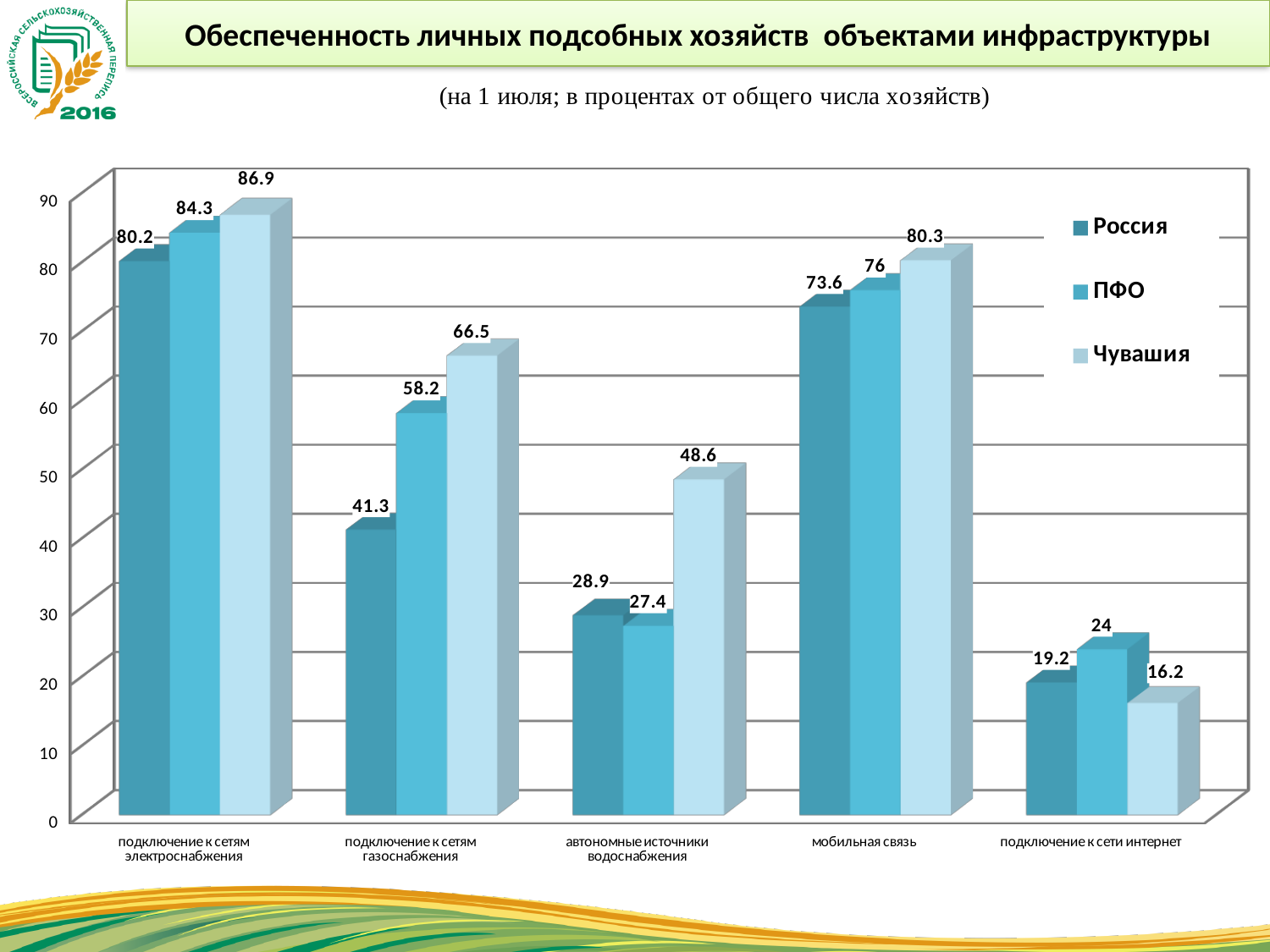
How many categories are shown on the x axis? 5 Which category has the highest value for Россия? подключение к сетям электроснабжения Which is larger for подключение к сети интернет: the value for ПФО or the value for Чувашия? ПФО How many series does the legend list? 3 Which category has the lowest value for Чувашия? подключение к сети интернет What is the difference between the Чувашия and Россия values for автономные источники водоснабжения? 19.7 What is the value for Россия for подключение к сетям газоснабжения? 41.3 What is the value for Чувашия for подключение к сетям электроснабжения? 86.9 What kind of chart is shown on the slide? bar chart What is the value for ПФО for мобильная связь? 76 What is the difference between the ПФО and Россия values for подключение к сетям газоснабжения? 16.9 What is the value for Чувашия for подключение к сети интернет? 16.2